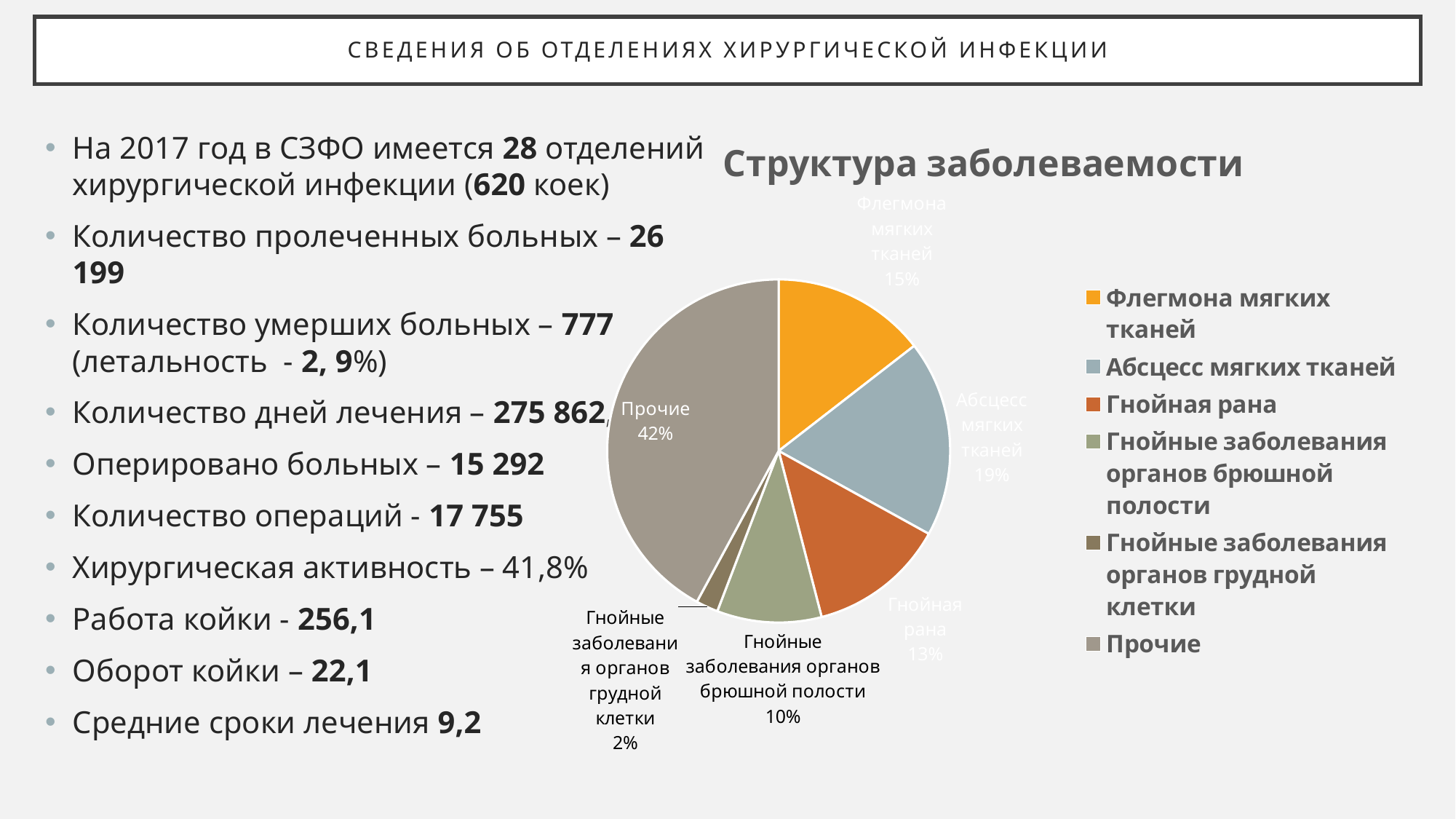
Which category has the largest slice of the pie? Прочие What is the title of the chart? Структура заболеваемости What share of the pie does "Прочие" take? 42% What is the value for "Флегмона мягких тканей"? 15% What is the value for "Гнойная рана"? 13% What is the value for "Абсцесс мягких тканей"? 19% What is the difference between the shares of "Абсцесс мягких тканей" and "Гнойная рана"? 6% How many categories does the legend list? 6 Which category has the smallest slice of the pie? Гнойные заболевания органов грудной клетки What is the value for "Гнойные заболевания органов грудной клетки"? 2% Which is larger: "Флегмона мягких тканей" or "Гнойные заболевания органов брюшной полости"? Флегмона мягких тканей What type of chart is shown on the slide? Pie chart